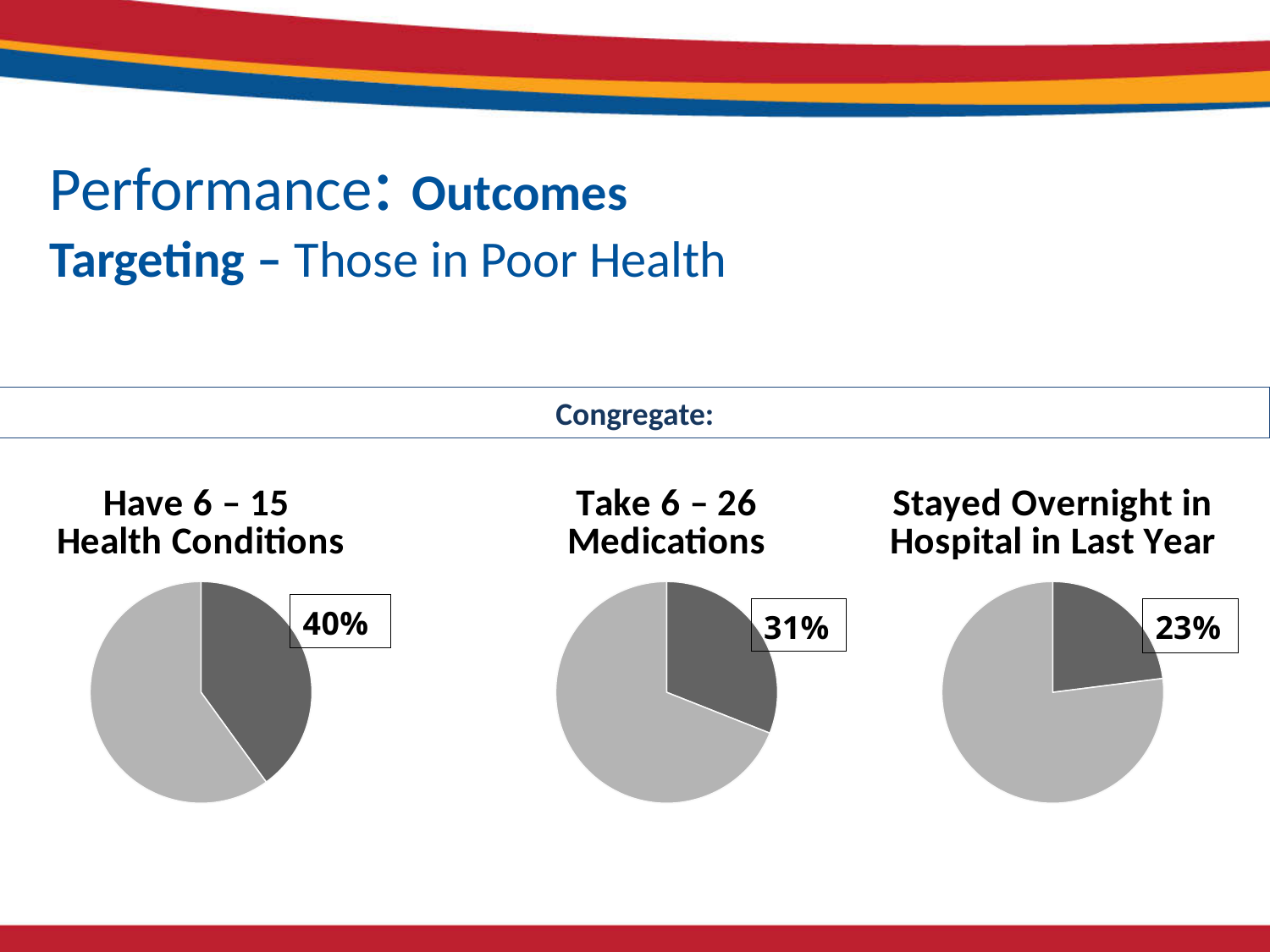
Which is larger: the labelled percentage in the 'Take 6 – 26 Medications' chart or in the 'Stayed Overnight in Hospital in Last Year' chart? Take 6 – 26 Medications What type of chart is used for 'Have 6 – 15 Health Conditions'? Pie chart In the 'Stayed Overnight in Hospital in Last Year' pie chart, what percentage is shown for the dark grey slice? 23% In the 'Have 6 – 15 Health Conditions' pie chart, what percentage is shown for the dark grey slice? 40% How many slices does the 'Stayed Overnight in Hospital in Last Year' pie chart have? 2 How many pie charts are shown on the slide? 3 What is the difference between the labelled percentage in the 'Take 6 – 26 Medications' chart and the 'Stayed Overnight in Hospital in Last Year' chart? 8% What is the difference between the labelled percentage in the 'Have 6 – 15 Health Conditions' chart and the 'Take 6 – 26 Medications' chart? 9% What is the heading shown in the box above the three pie charts? Congregate: Across the three pie charts, which one shows the highest labelled percentage? Have 6 – 15 Health Conditions Across the three pie charts, which one shows the lowest labelled percentage? Stayed Overnight in Hospital in Last Year In the 'Take 6 – 26 Medications' pie chart, what percentage is shown for the dark grey slice? 31%